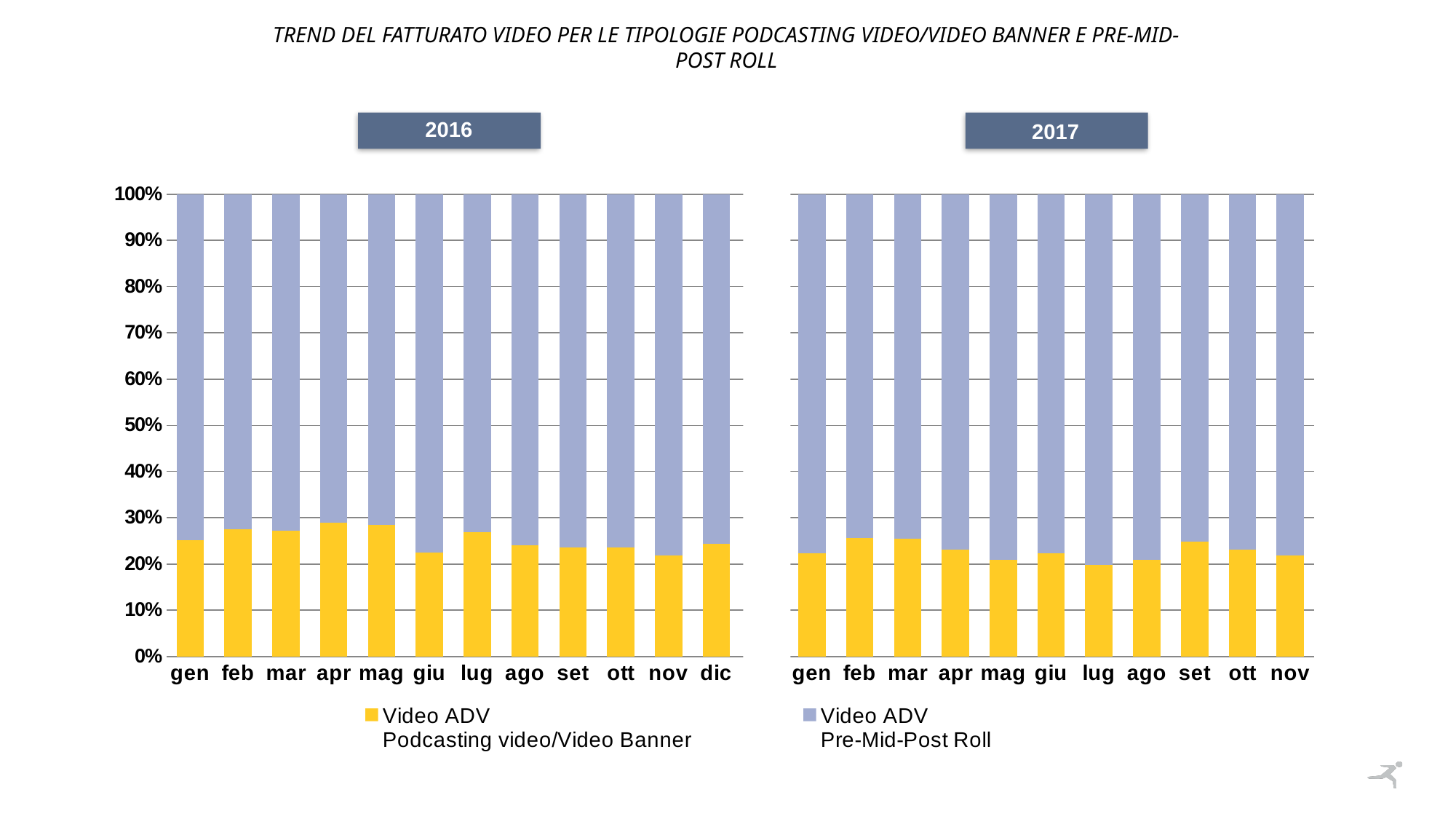
In the 2017 chart, which has the larger Video ADV Podcasting video/Video Banner share, feb or lug? feb In the 2017 chart, is the Video ADV Pre-Mid-Post Roll share for feb greater or less than 70%? greater In the 2016 chart, is the Video ADV Podcasting video/Video Banner share for giu greater or less than 30%? less Which colour represents Video ADV Pre-Mid-Post Roll in the legend? Blue In the 2016 chart, which has the larger Video ADV Podcasting video/Video Banner share, apr or giu? apr How many series does the legend list? 2 In the 2016 chart, does the Video ADV Podcasting video/Video Banner share rise or fall from apr to giu? fall In the 2016 chart, is the Video ADV Podcasting video/Video Banner share for nov greater or less than 20%? greater In the 2016 chart, how many months are shown on the x axis? 12 What kind of chart is shown on the slide? Stacked bar chart In the 2017 chart, how many months are shown on the x axis? 11